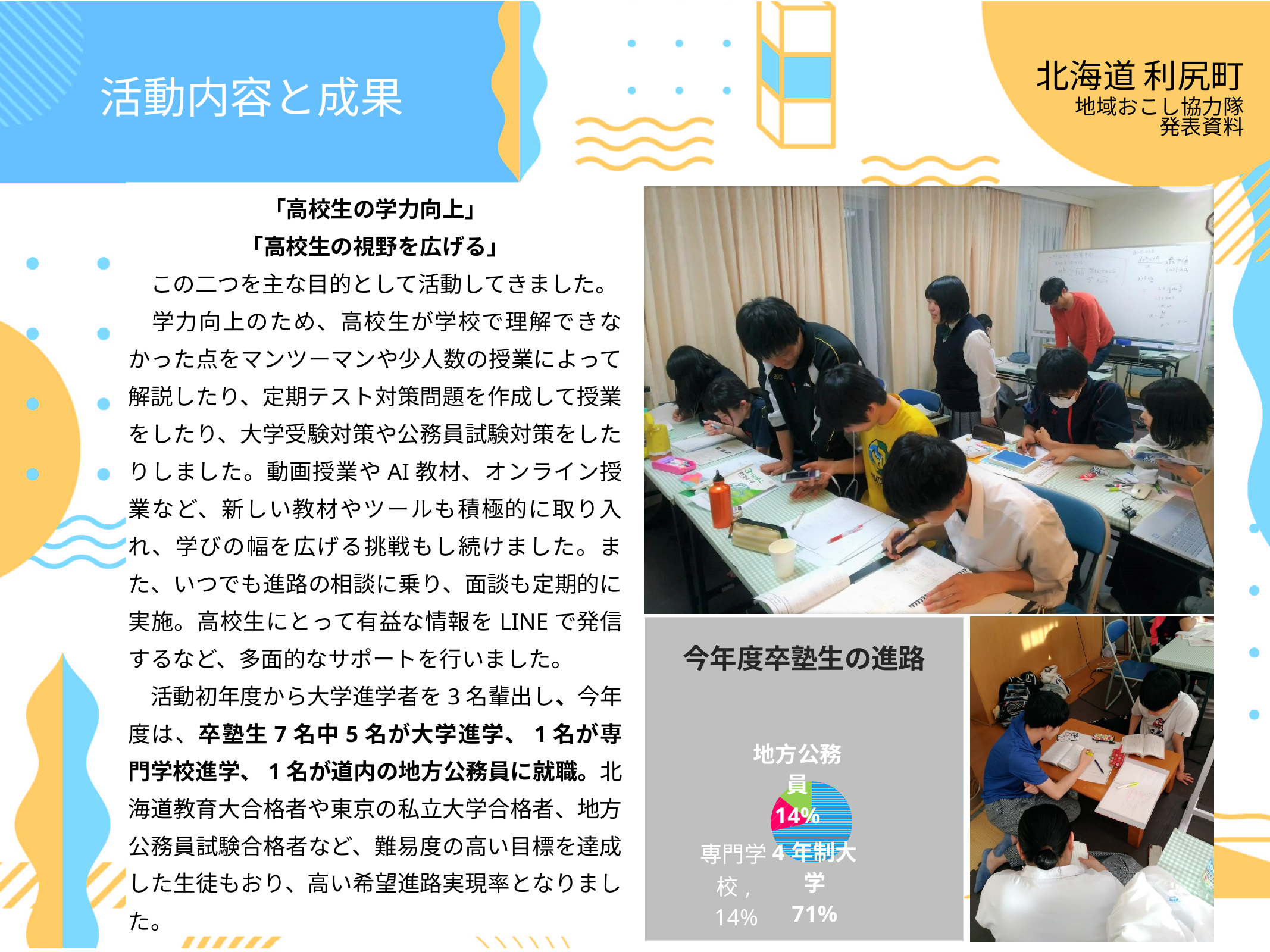
In the pie chart 今年度卒塾生の進路, is the share for 4年制大学 greater or less than 50%? greater What is the title of the pie chart on the slide? 今年度卒塾生の進路 In the pie chart 今年度卒塾生の進路, what colour is the 4年制大学 slice? blue In the pie chart 今年度卒塾生の進路, what percentage is shown for 専門学校? 14% Which category has the largest slice in the pie chart 今年度卒塾生の進路? 4年制大学 What kind of chart is shown under the title 今年度卒塾生の進路? pie chart How many slices does the pie chart 今年度卒塾生の進路 have? 3 In the pie chart 今年度卒塾生の進路, what share is labelled for 4年制大学? 71% In the pie chart 今年度卒塾生の進路, what percentage is shown for 地方公務員? 14% In the pie chart 今年度卒塾生の進路, what is the difference between the 4年制大学 share and the 地方公務員 share? 57% In the pie chart 今年度卒塾生の進路, which is larger: 4年制大学 or 地方公務員? 4年制大学 In the pie chart 今年度卒塾生の進路, what is the difference in percentage points between 4年制大学 and 専門学校? 57%